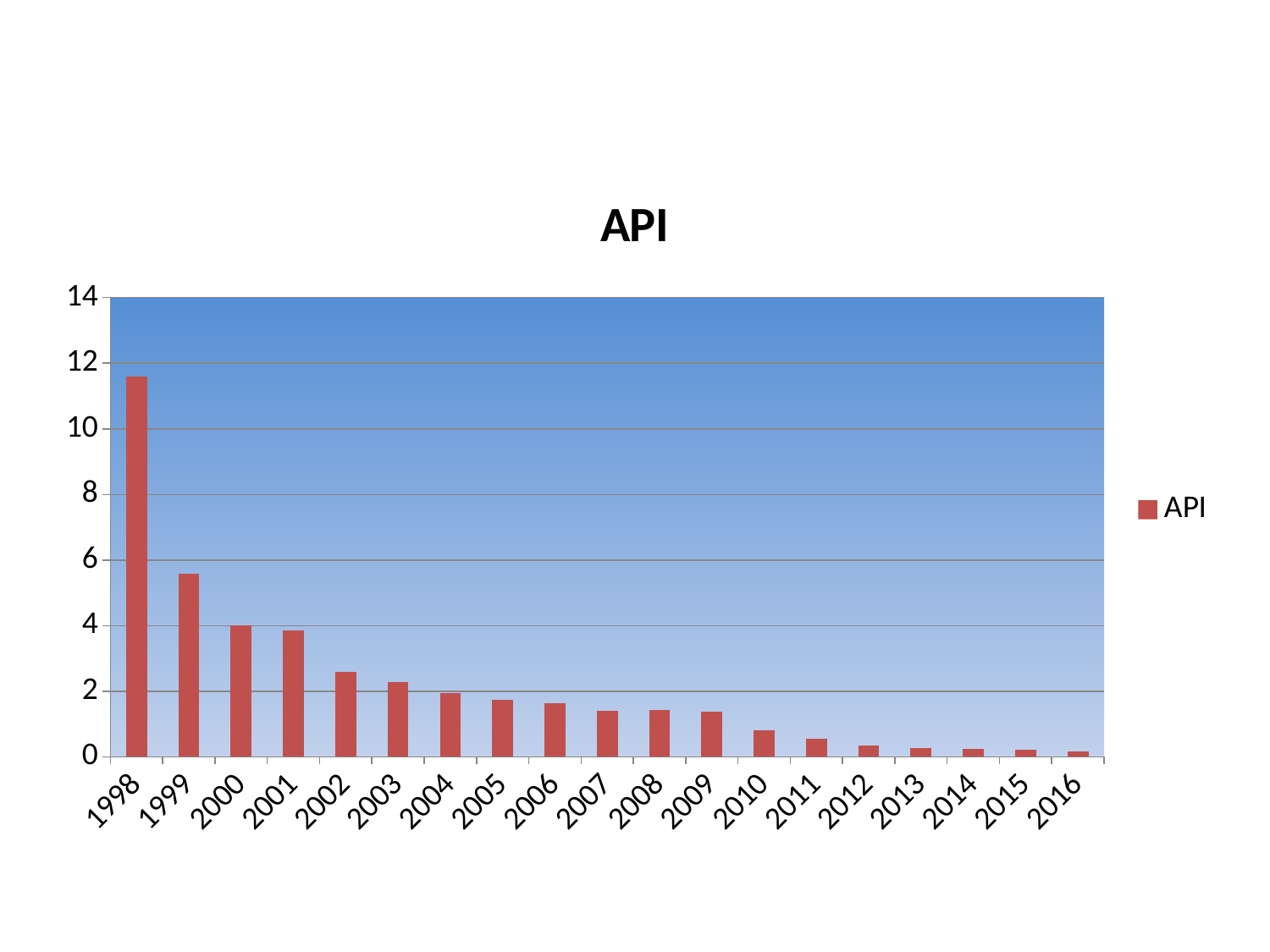
Is the value for 1999 greater or less than 6? less Is the value for 2002 greater or less than 2? greater Which year has the highest value? 1998 Is the value for 2010 greater or less than 2? less Which is larger, the value for 2004 or the value for 2011? 2004 Do the values rise or fall from 1998 to 2016? fall Which is larger, the value for 1998 or the value for 1999? 1998 What kind of chart is shown on the slide? bar chart How many years are shown on the x axis? 19 How many series does the legend list? 1 What is the title of the chart? API